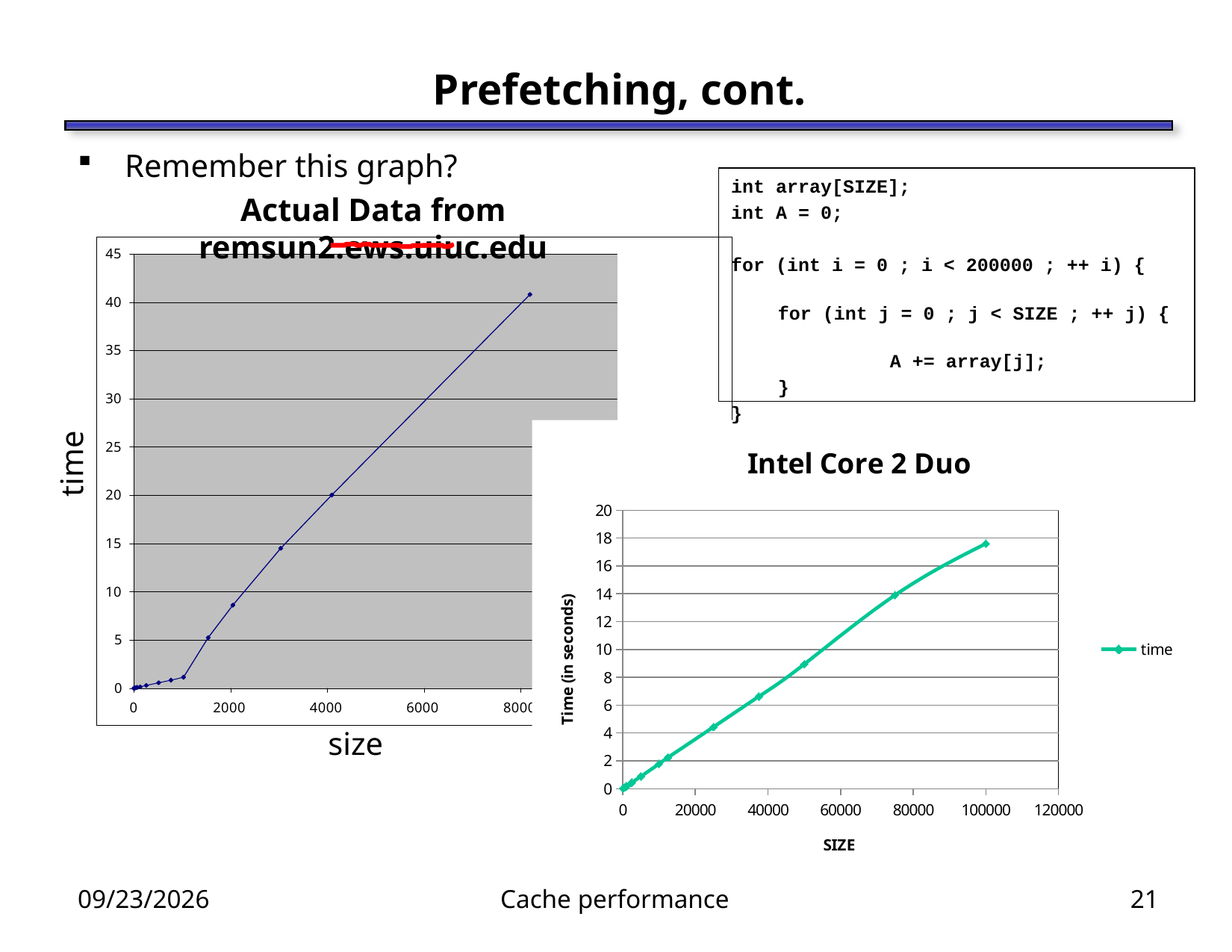
What kind of chart is the 'Intel Core 2 Duo' chart? line chart In the 'Actual Data from remsun2.ews.uiuc.edu' chart, is the time at size 2000 greater or less than 10? less In the 'Actual Data from remsun2.ews.uiuc.edu' chart, does time rise or fall as size increases? rise In the 'Intel Core 2 Duo' chart, is the value at SIZE 100000 greater or less than 15? greater In the 'Intel Core 2 Duo' chart, do the values rise or fall as SIZE increases? rise In the 'Intel Core 2 Duo' chart, is the value at SIZE 75000 greater or less than 12? greater What kind of chart is the 'Actual Data from remsun2.ews.uiuc.edu' chart on the left? line chart In the 'Intel Core 2 Duo' chart, how many series does the legend list? 1 In the 'Intel Core 2 Duo' chart, what is the label of the vertical axis? Time (in seconds) In the 'Intel Core 2 Duo' chart, what is the name of the series shown in the legend? time